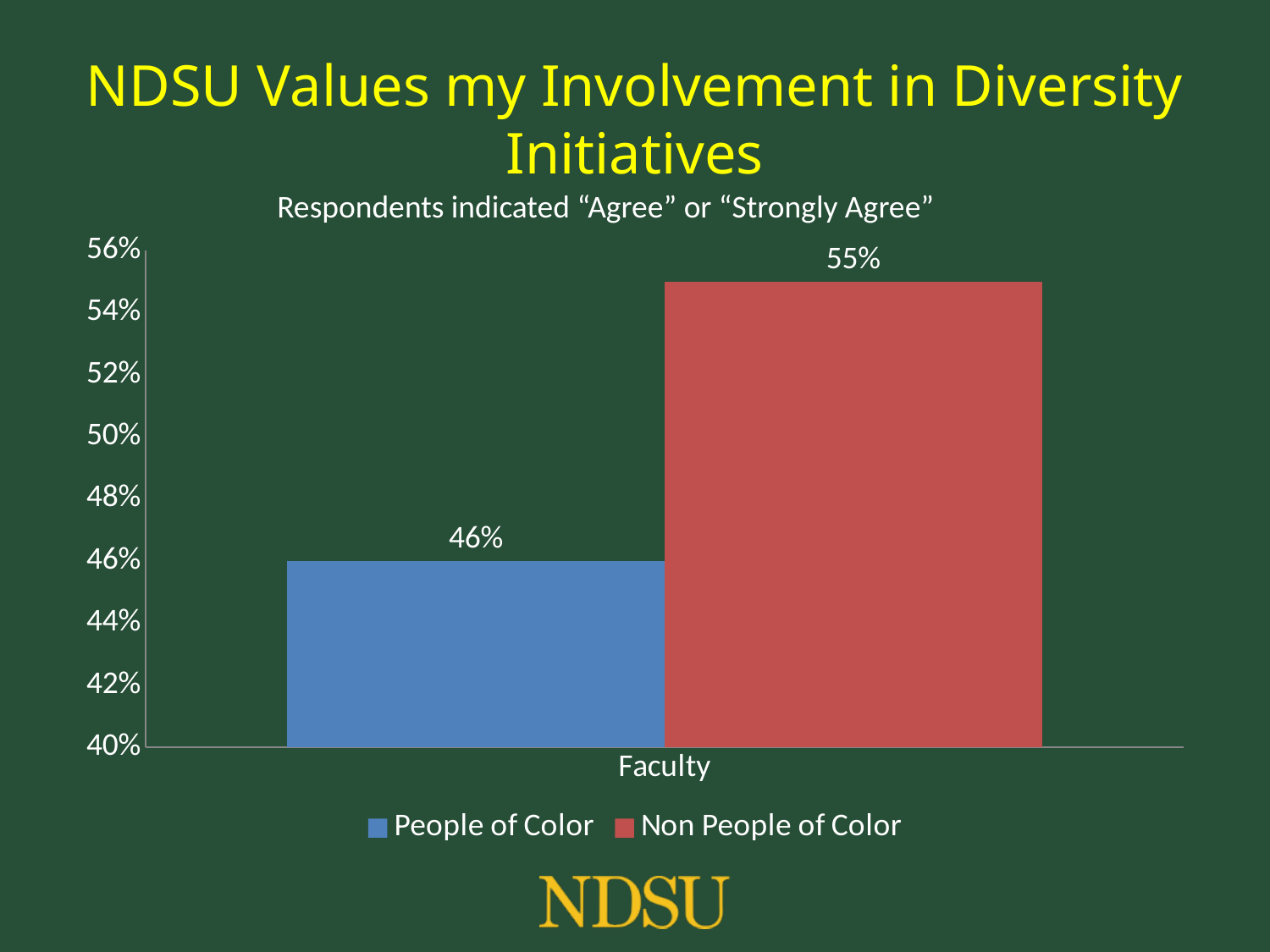
How many categories are shown on the x axis? 1 What percentage of People of Color faculty agreed or strongly agreed that NDSU values their involvement in diversity initiatives? 46% Which series has the lower value for Faculty? People of Color What is the difference in percentage points between Non People of Color and People of Color faculty? 9 percentage points Which series has the higher value for Faculty? Non People of Color What is the category label on the x axis? Faculty Is the value for People of Color greater or less than 50%? less Is the value for Non People of Color greater or less than 50%? greater What percentage of Non People of Color faculty agreed or strongly agreed? 55% What colour is the bar for Non People of Color? Red What kind of chart is shown on the slide? Bar chart How many series does the legend list? 2